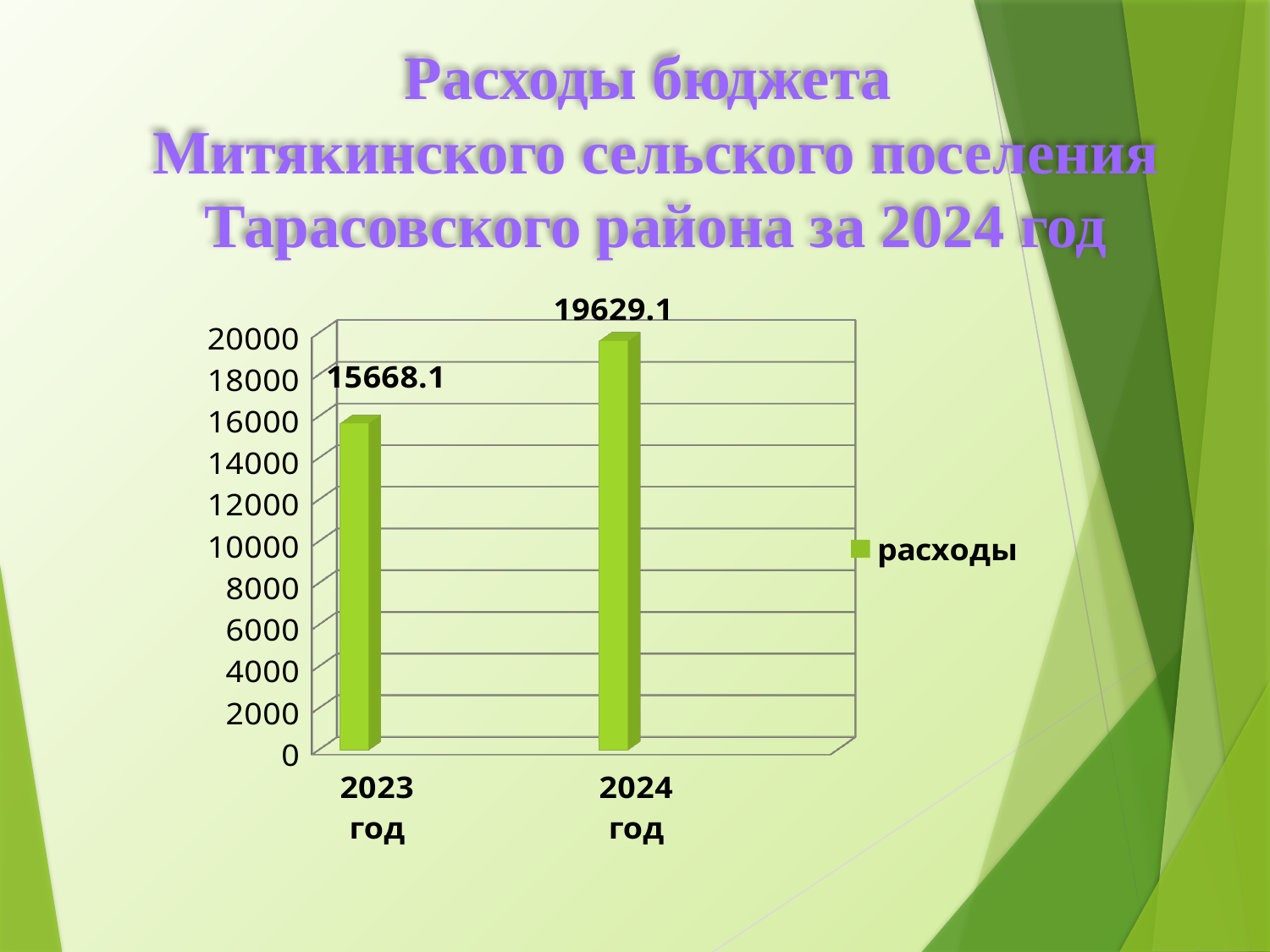
Is the value for 2023 год greater or less than 16000? less Which is larger, the value for 2023 год or 2024 год? 2024 год Which year has the highest value? 2024 год What is the value for 2024 год? 19629.1 Which year has the lowest value? 2023 год What is the name of the series in the legend? расходы What is the difference between the values for 2024 год and 2023 год? 3961 How many series does the legend list? 1 Is the value for 2024 год greater or less than 18000? greater What is the value for 2023 год? 15668.1 How many categories are shown on the x axis? 2 What kind of chart is shown on the slide? bar chart